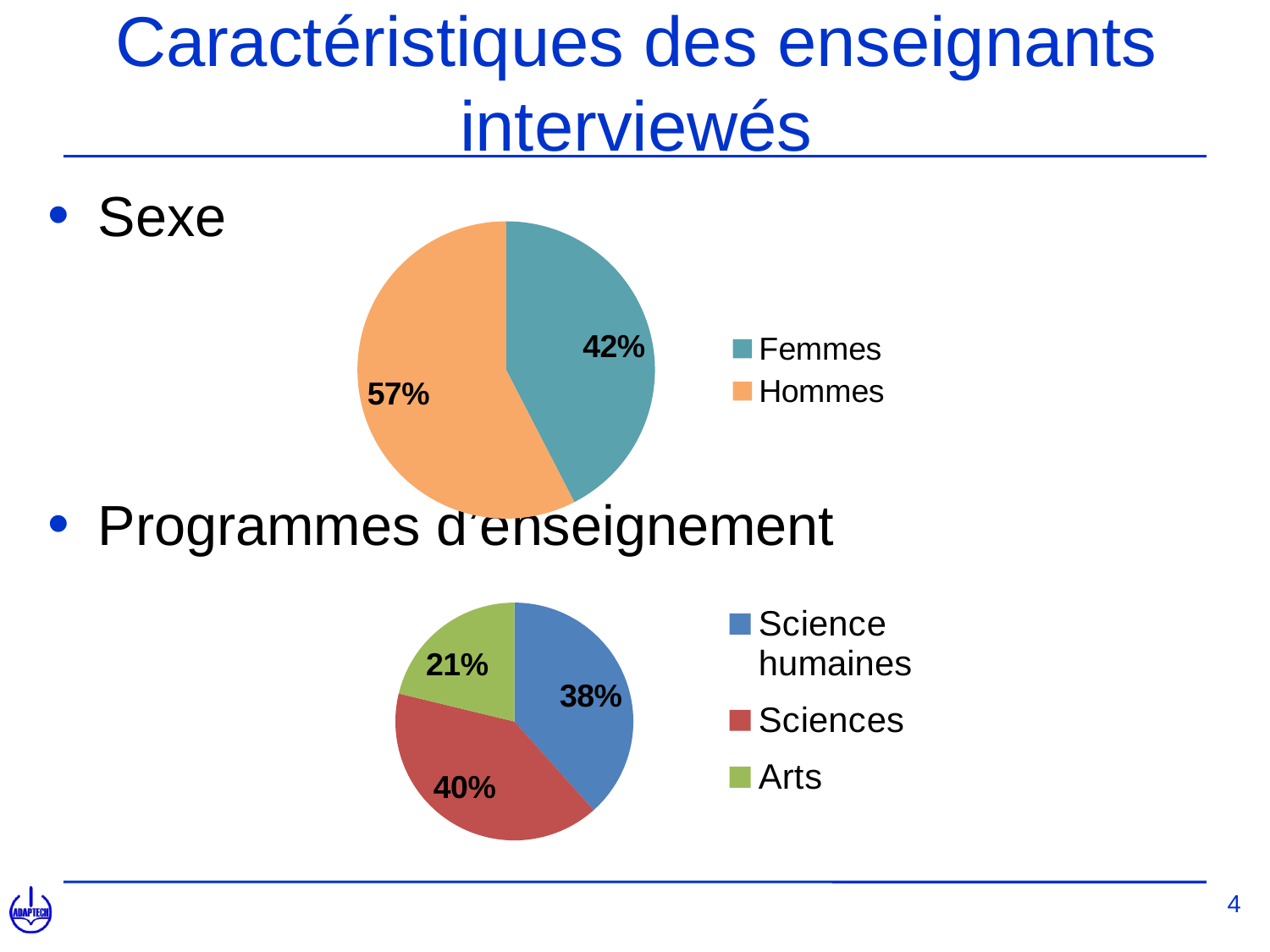
In the bottom pie chart (Programmes d'enseignement), what share is labelled for Sciences? 40% In the bottom pie chart (Programmes d'enseignement), which is larger: Sciences or Science humaines? Sciences In the top pie chart (Sexe), what colour is the Hommes slice? Orange In the bottom pie chart (Programmes d'enseignement), how many slices are there? 3 In the top pie chart (Sexe), which category has the larger slice? Hommes In the top pie chart (Sexe), how many categories does the legend list? 2 In the bottom pie chart (Programmes d'enseignement), what share is labelled for Arts? 21% In the bottom pie chart (Programmes d'enseignement), what share is labelled for Science humaines? 38% In the top pie chart (Sexe), what share is labelled for Femmes? 42% In the top pie chart (Sexe), what share is labelled for Hommes? 57% In the bottom pie chart (Programmes d'enseignement), which category has the smallest slice? Arts What kind of chart is shown under the bullet 'Sexe'? Pie chart